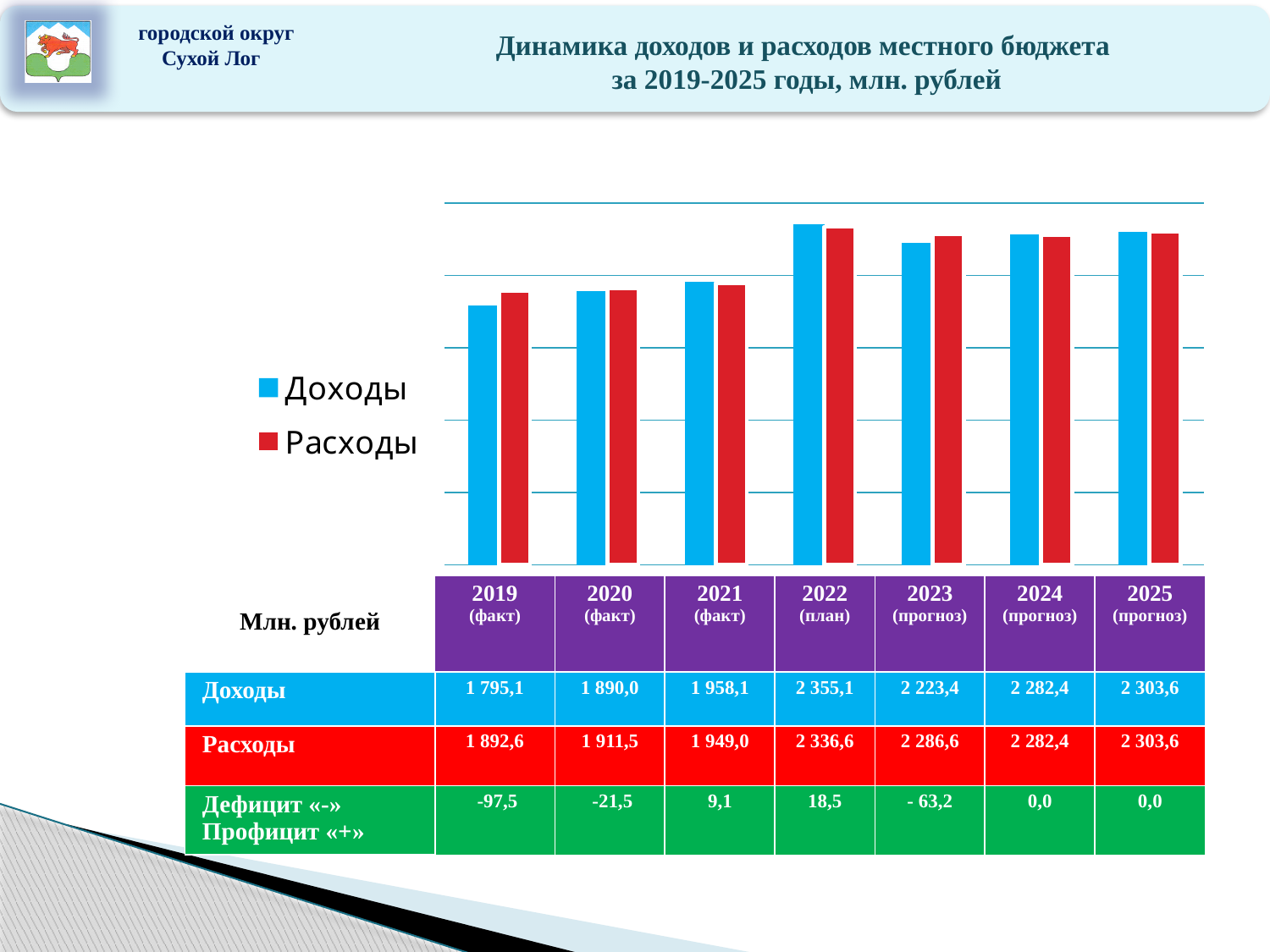
How many series does the chart legend list? 2 What kind of chart is shown on the slide? bar chart What is the value of Доходы for 2022 (план)? 2 355,1 In which year is Доходы the highest? 2022 What is the value of Расходы for 2023 (прогноз)? 2 286,6 Do the Доходы values generally rise or fall from 2019 to 2022? rise What is the difference between Расходы and Доходы in 2019? 97,5 What is the value of Доходы for 2019 (факт)? 1 795,1 Which colour represents Расходы in the chart? red In which year is Расходы the lowest? 2019 Which is larger in 2019: Доходы or Расходы? Расходы How many years (categories) are shown along the x axis of the chart? 7